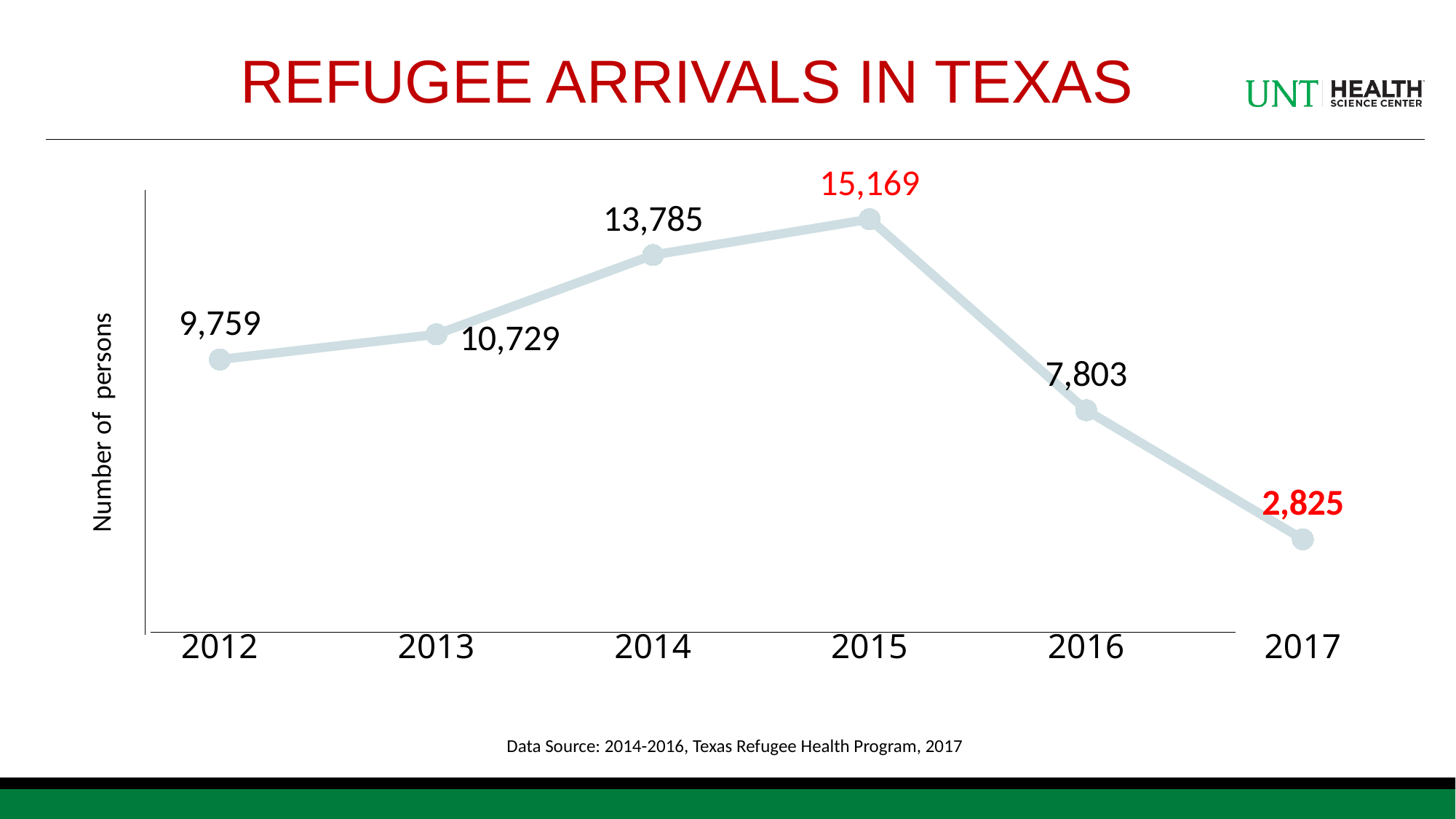
Which year had the lowest number of refugee arrivals in Texas? 2017 Do refugee arrivals rise or fall from 2015 to 2017? Fall What was the number of refugee arrivals in Texas in 2012? 9,759 How many years are plotted on the chart? 6 What is the difference in refugee arrivals between 2015 and 2016? 7,366 What is the difference in refugee arrivals between 2016 and 2017? 4,978 What was the number of refugee arrivals in Texas in 2015? 15,169 What was the number of refugee arrivals in Texas in 2017? 2,825 Which year had more refugee arrivals, 2013 or 2016? 2013 Which year had the highest number of refugee arrivals in Texas? 2015 What was the number of refugee arrivals in Texas in 2014? 13,785 What kind of chart is shown on the slide? Line chart